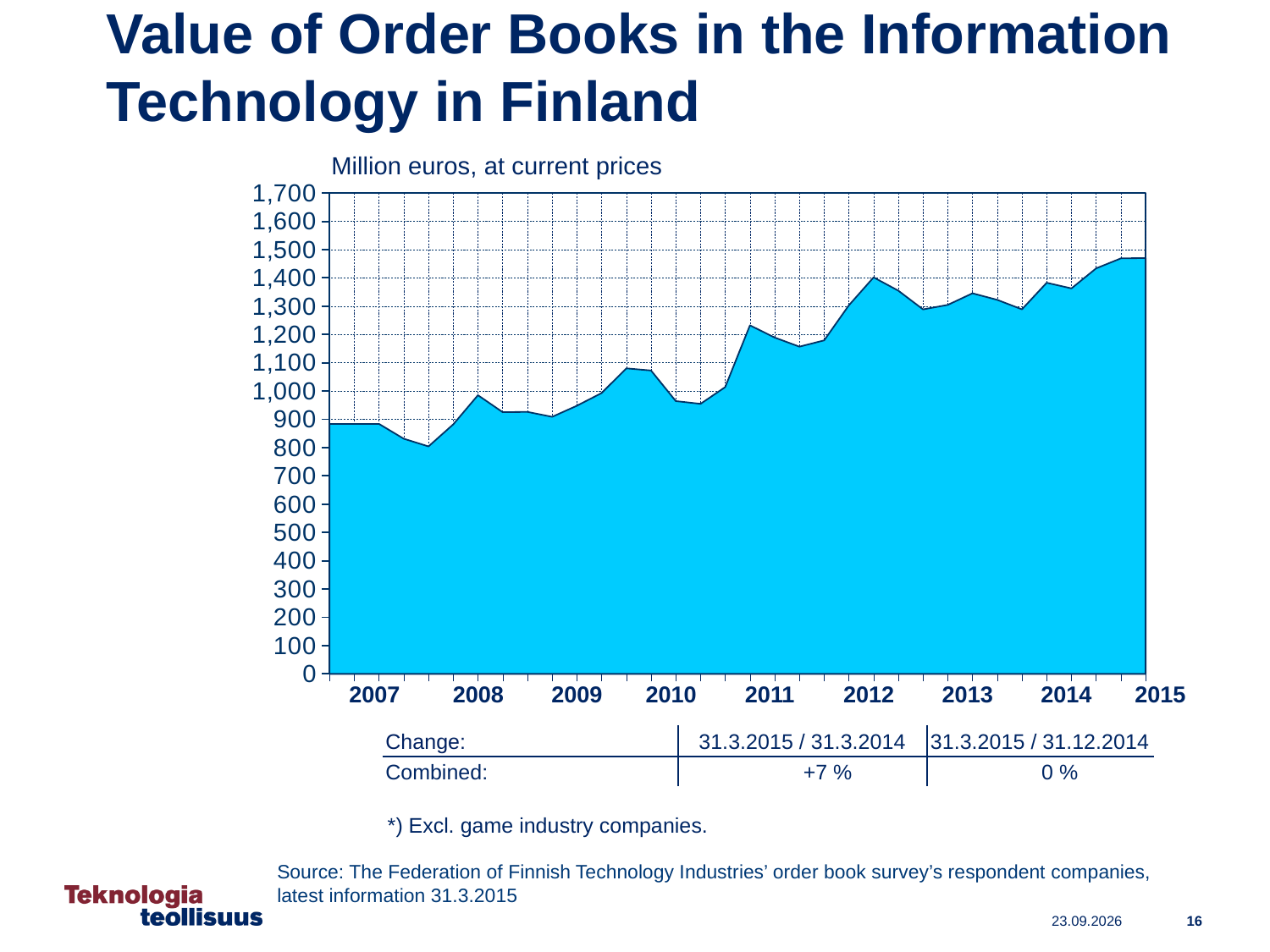
In which year does the chart reach its lowest value? 2007 What kind of chart is shown on the slide? area chart Overall, do the values rise or fall from 2007 to 2015? rise Is the value at 2011 greater or less than 1,100? greater Is the lowest point of the chart, in late 2007, greater or less than 900? less What is the title of the chart on the slide? Value of Order Books in the Information Technology in Finland In what units are the values on the chart expressed? Million euros, at current prices How many year labels are shown on the x axis of the chart? 9 Is the value at 2015 greater or less than 1,400? greater Which is larger, the value at 2015 or the value at 2007? 2015